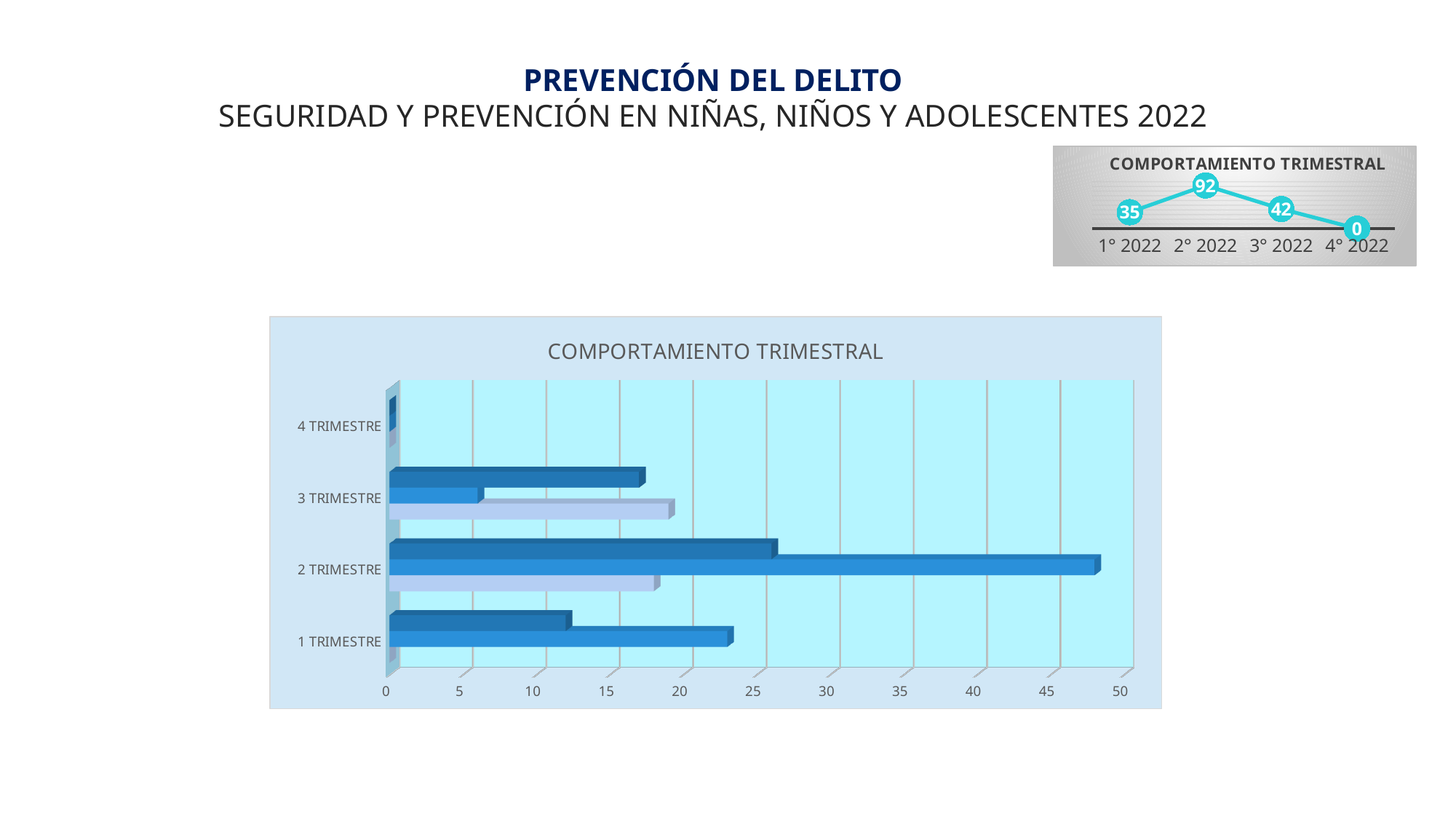
In the line chart at the top right, what is the difference between the values for 2° 2022 and 3° 2022? 50 In the line chart at the top right, which is larger, the value for 1° 2022 or the value for 3° 2022? 3° 2022 How many data points are plotted in the line chart at the top right? 4 In the line chart at the top right, what is the value for 4° 2022? 0 In the line chart at the top right, which quarter has the highest value? 2° 2022 In the line chart at the top right, what is the value for 2° 2022? 92 In the large bar chart, is the longest bar for 3 TRIMESTRE greater or less than 25? less In the line chart at the top right, what is the value for 1° 2022? 35 In the line chart at the top right, which quarter has the lowest value? 4° 2022 What kind of chart is the large chart in the lower part of the slide? Bar chart What is the title of the large bar chart? COMPORTAMIENTO TRIMESTRAL In the large bar chart, is the longest bar for 2 TRIMESTRE greater or less than 45? greater